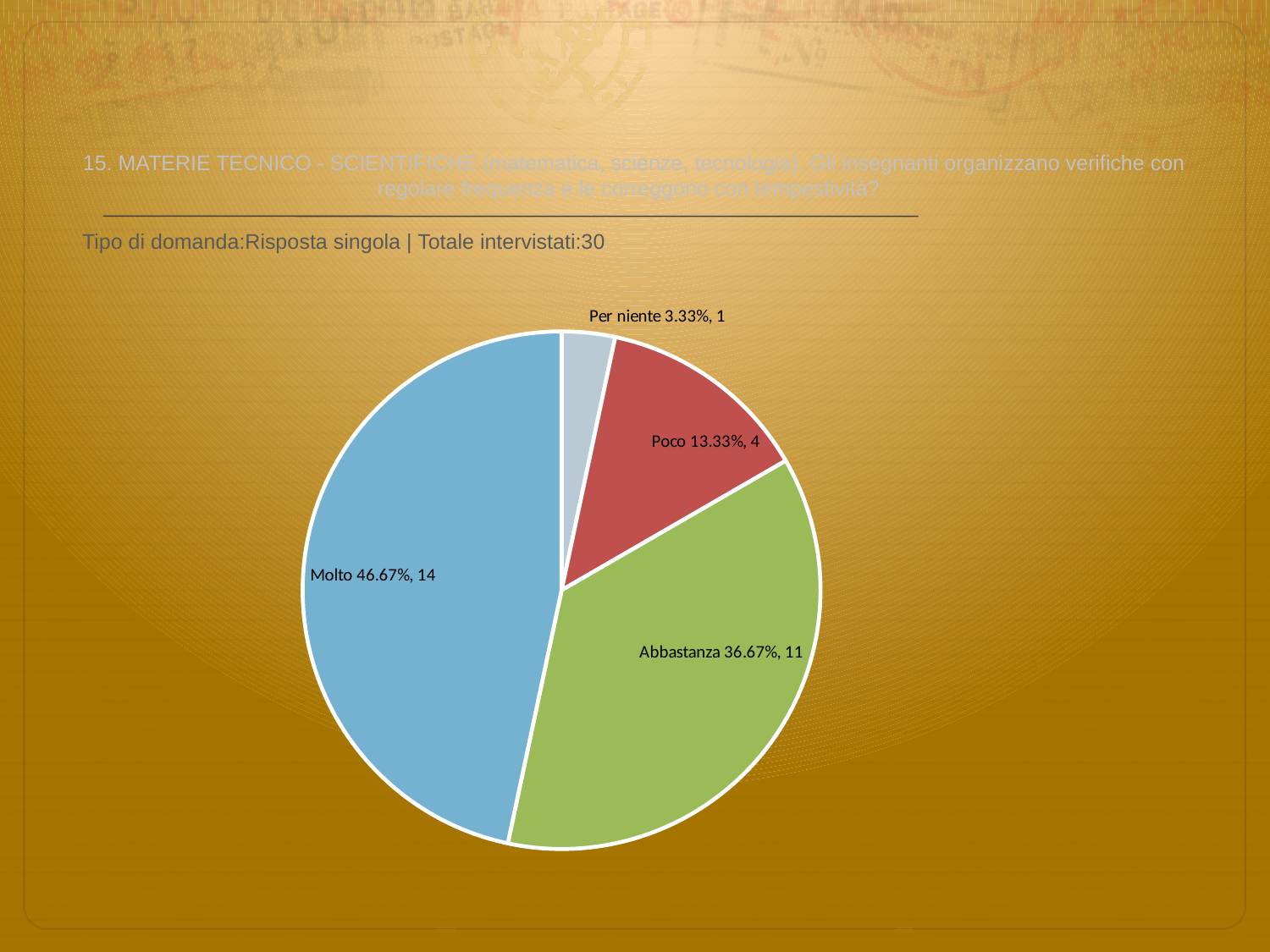
What percentage share does the 'Poco' slice have? 13.33% How many respondents answered 'Molto'? 14 How many respondents answered 'Abbastanza'? 11 How many slices does the pie chart have? 4 What percentage share does the 'Molto' slice have? 46.67% What type of chart is shown on the slide? pie chart What is the difference in respondent count between 'Molto' and 'Abbastanza'? 3 What percentage share does the 'Per niente' slice have? 3.33% Which category has the smallest slice? Per niente Which has more respondents, 'Poco' or 'Per niente'? Poco Which category has the largest slice? Molto